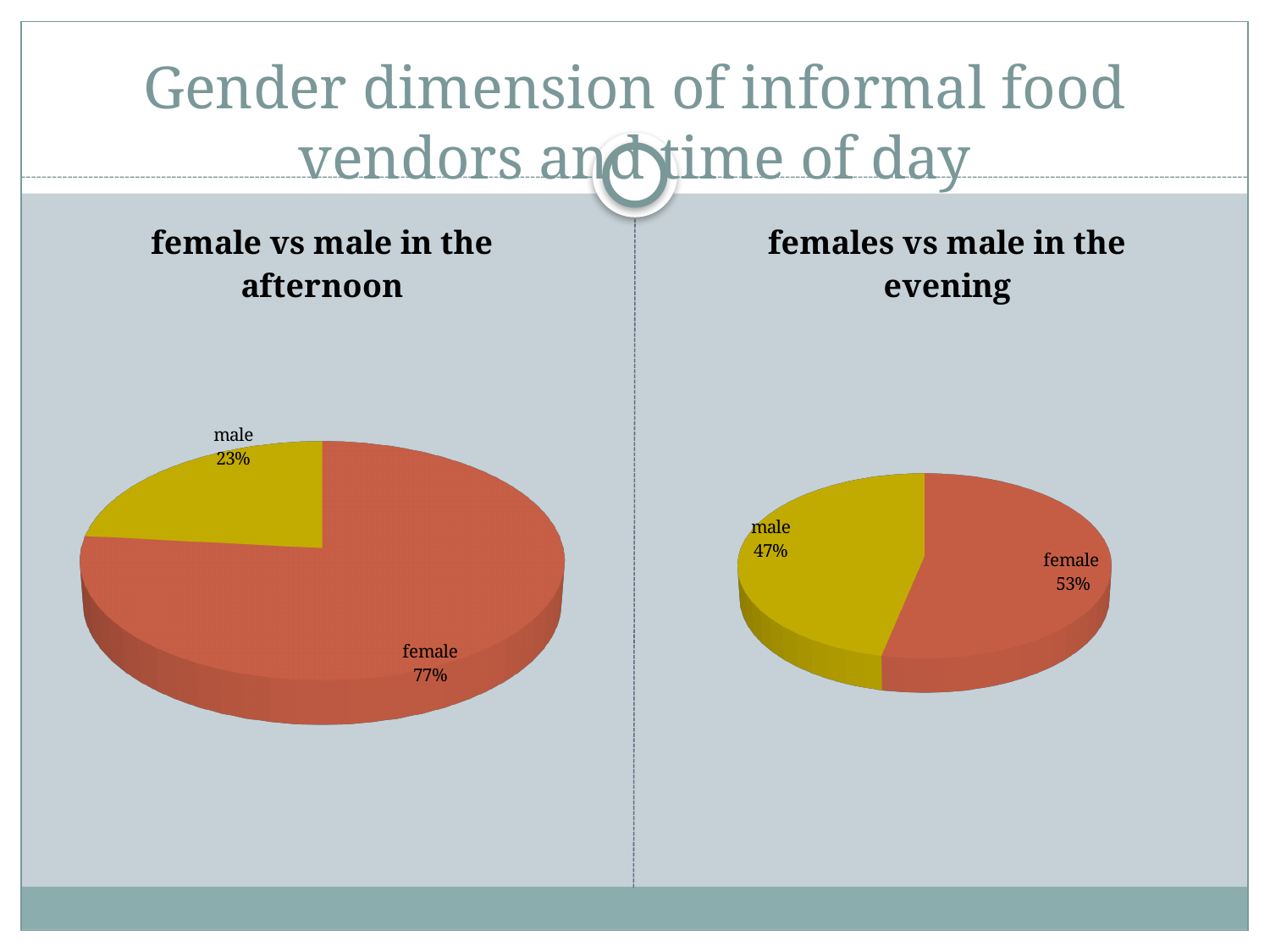
In the 'female vs male in the afternoon' chart, what share of the pie is female? 77% How many slices does the 'females vs male in the evening' chart have? 2 Is the male share larger in the afternoon chart or in the evening chart? evening chart What colour is the female slice in the 'female vs male in the afternoon' chart? red/orange In the 'female vs male in the afternoon' chart, which slice is the largest? female In the 'females vs male in the evening' chart, which slice is the smallest? male In the 'females vs male in the evening' chart, what is the difference between the female and male shares? 6% In the 'females vs male in the evening' chart, what share of the pie is female? 53% What kind of chart is the 'female vs male in the afternoon' chart? pie chart In the 'females vs male in the evening' chart, what share of the pie is male? 47% In the 'female vs male in the afternoon' chart, what is the difference between the female and male shares? 54%